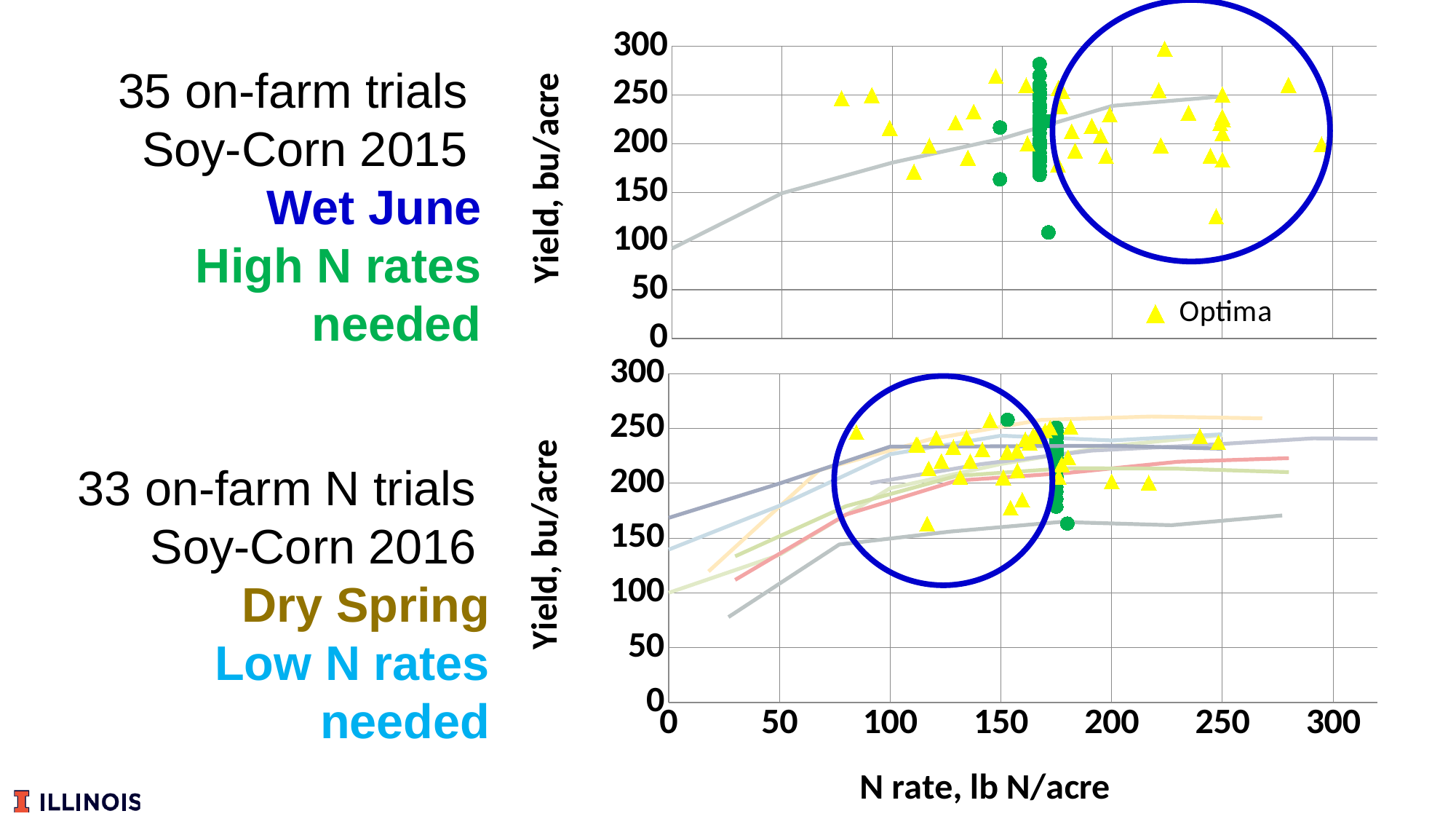
In the top chart, is the yield of the highest Optima point greater or less than 250? greater How many series does the legend in the top chart list? 1 In the top chart, is the yield of the lowest Optima point greater or less than 150? less What kind of chart is the top chart on the slide? scatter chart In the bottom chart, is the yield of the lowest Optima point greater or less than 200? less In the top chart, does the gray line rise or fall as N rate increases from 0 to 250? rises What is the x-axis label shown beneath the bottom chart? N rate, lb N/acre What is the y-axis label of the top chart? Yield, bu/acre In the top chart, what series name does the legend list? Optima How many charts are shown on the slide? 2 In the top chart, what is the highest value shown on the y-axis? 300 In the bottom chart, what is the highest tick label shown on the x-axis? 300